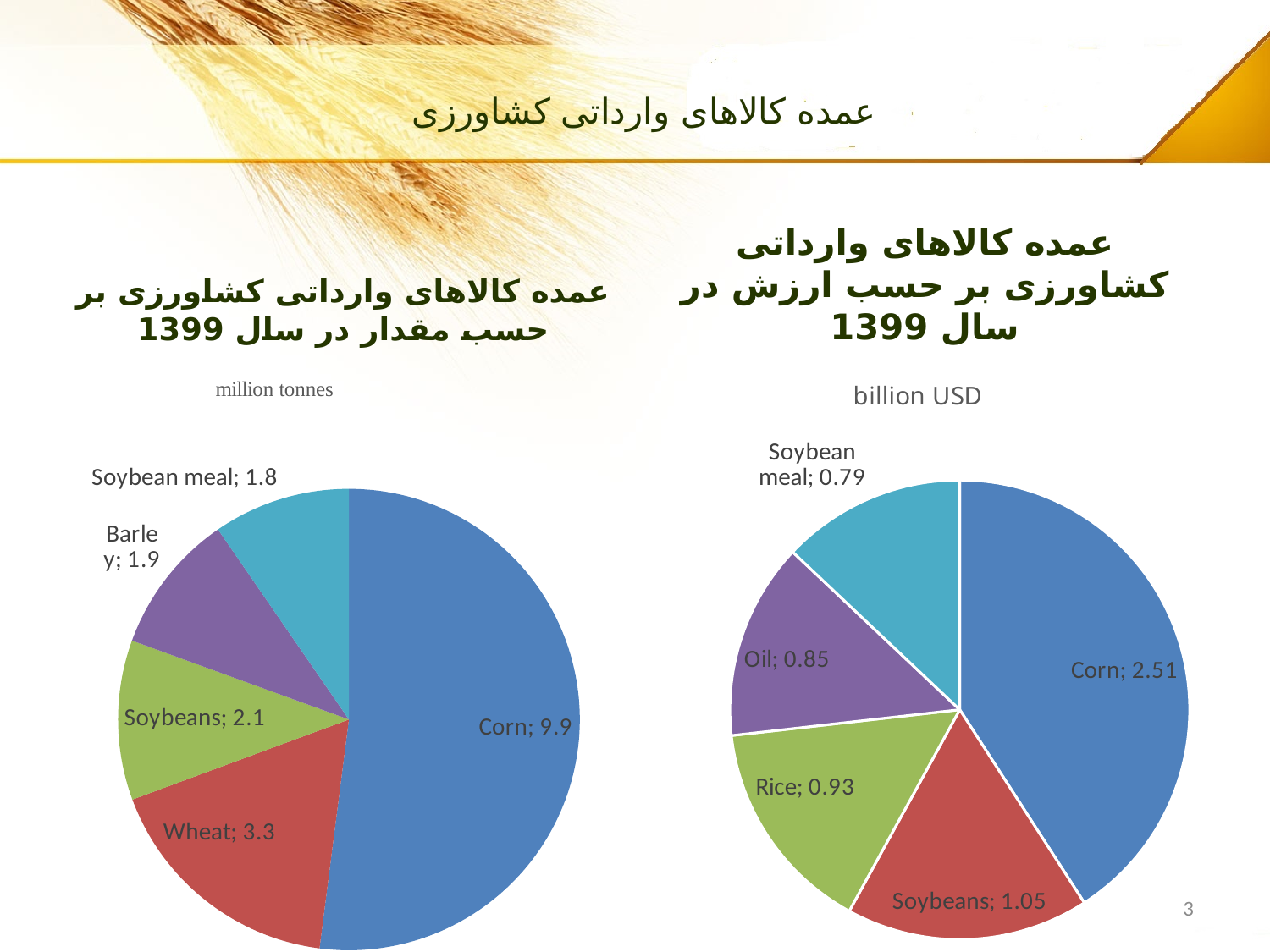
In the right pie chart (billion USD), which category has the smallest slice? Soybean meal How many categories are shown in the left pie chart (million tonnes)? 5 In the left pie chart (million tonnes), what is the value for Wheat? 3.3 In the right pie chart (billion USD), what is the value for Rice? 0.93 In the left pie chart (million tonnes), what is the total of all slices? 19 In the left pie chart (million tonnes), what is the difference between Wheat and Soybeans? 1.2 What type of chart is used on the right side of the slide? Pie chart In the right pie chart (billion USD), what is the difference between Corn and Soybeans? 1.46 In the left pie chart (million tonnes), what is the value for Corn? 9.9 What unit label is shown above the right pie chart? billion USD In the left pie chart (million tonnes), which category has the largest slice? Corn In the right pie chart (billion USD), which is larger, Oil or Rice? Rice